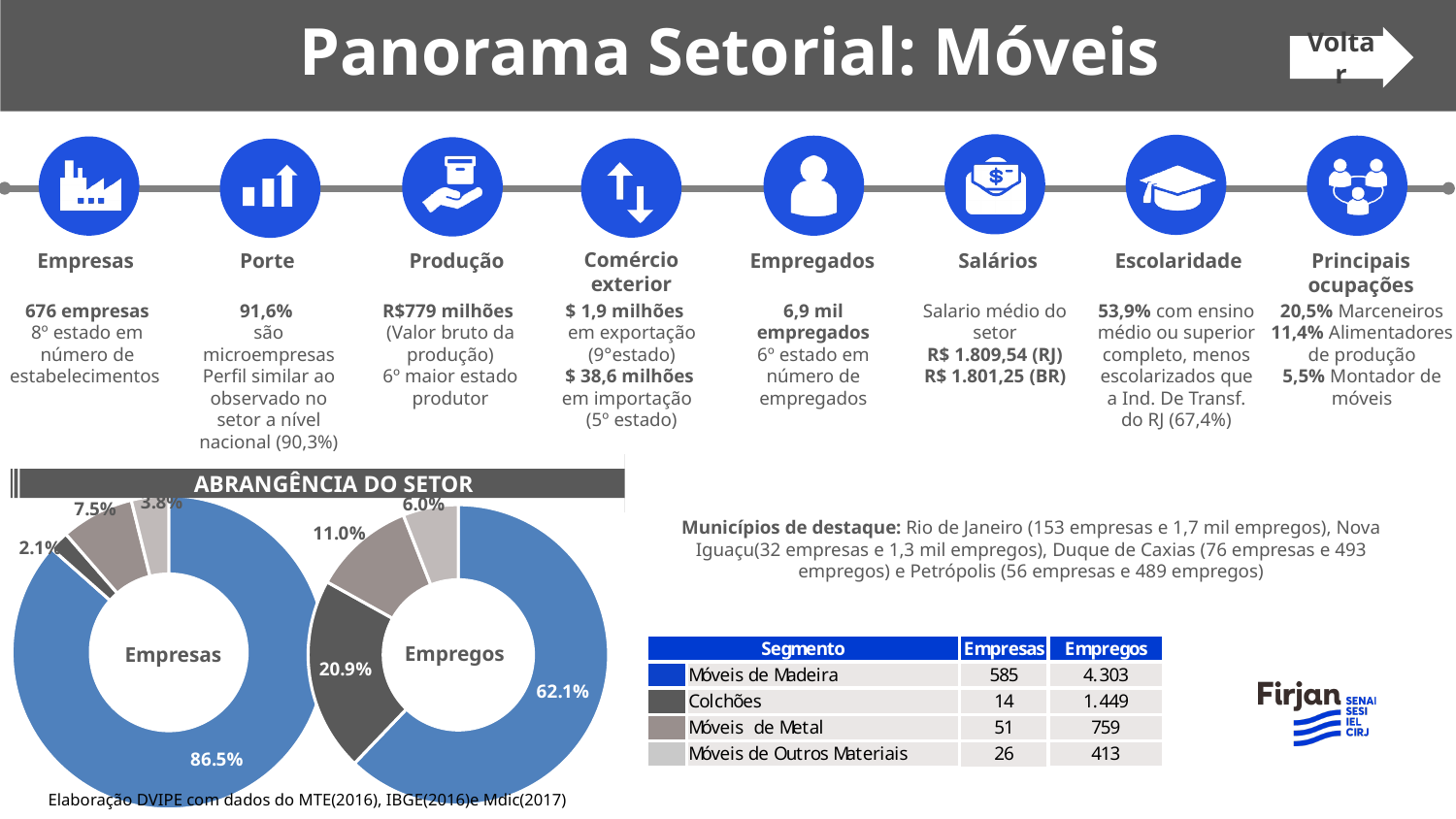
In the Empregos donut chart, what is the combined share of the Colchões (20.9%) and Móveis de Metal (11.0%) slices? 31.9% In the Empresas donut chart, what share is shown for the largest slice (Móveis de Madeira, blue)? 86.5% In the Empregos donut chart, which segment has the largest share? Móveis de Madeira (62.1%) What type of chart is used to show the Empresas and Empregos breakdowns? Donut (pie) chart In the Empregos donut chart, what share is shown for the Móveis de Metal (grey) slice? 11.0% How many slices does each donut chart under 'Abrangência do Setor' have? 4 What is the difference between the Móveis de Madeira share in the Empresas chart (86.5%) and in the Empregos chart (62.1%)? 24.4 percentage points In the Empresas donut chart, what share is shown for the Móveis de Outros Materiais (light grey) slice? 3.8% What is the title of the section containing the two donut charts? Abrangência do Setor In the Empregos donut chart, what share is shown for the Colchões (dark grey) slice? 20.9% Is the Colchões share larger in the Empresas chart or in the Empregos chart? Empregos In the Empresas donut chart, which segment has the smallest share? Colchões (2.1%)